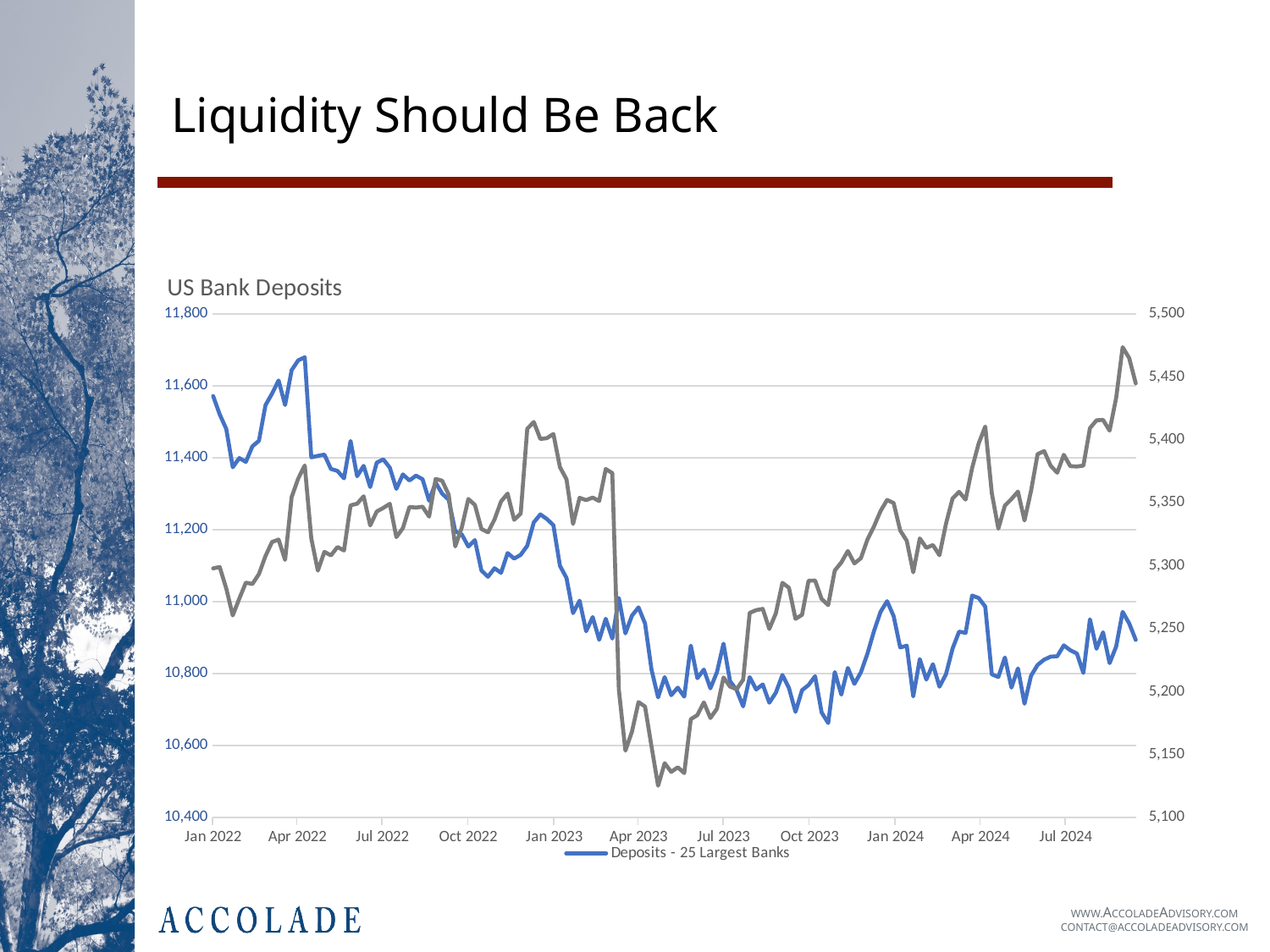
What type of chart is shown on the slide? Line chart Which is larger for Deposits - 25 Largest Banks: the value in Jan 2022 or the value in Jan 2024? Jan 2022 Around which month does the Deposits - 25 Largest Banks line reach its highest point? Apr 2022 How many series does the chart legend list? 1 Does the Deposits - 25 Largest Banks line rise or fall overall from Jan 2022 to Jul 2024? fall Is the value for Deposits - 25 Largest Banks in Jul 2022 greater or less than 11,200? greater Is the value for Deposits - 25 Largest Banks in Jul 2024 greater or less than 11,000? less What is the title of the chart? US Bank Deposits Is the value for Deposits - 25 Largest Banks in Jan 2022 greater or less than 11,400? greater What is the name of the series listed in the legend? Deposits - 25 Largest Banks Does the Deposits - 25 Largest Banks line rise or fall from Apr 2022 to Apr 2023? fall